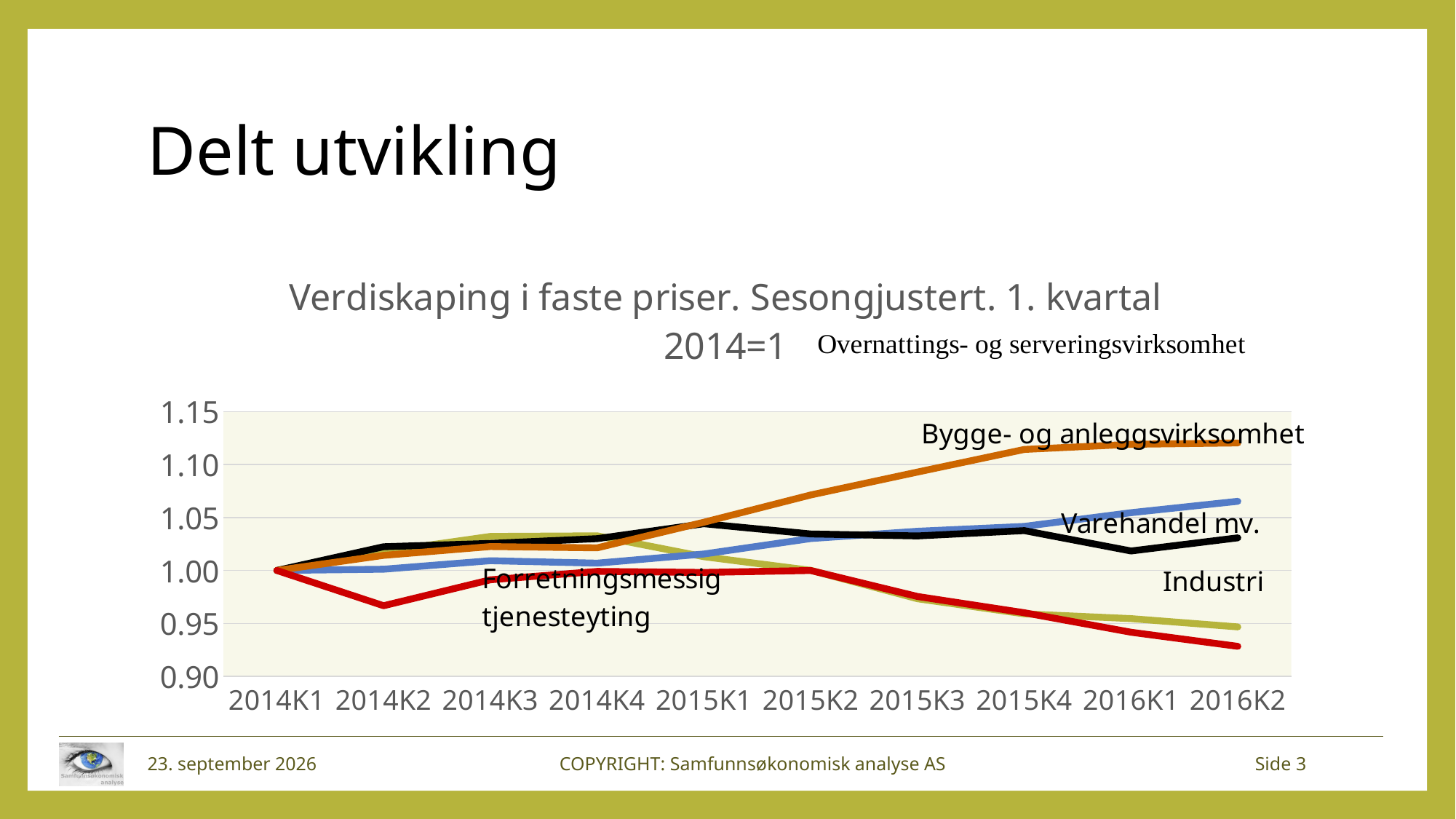
How many quarters are shown along the x axis of the chart? 10 Which series has the highest value at 2016K2? Overnattings- og serveringsvirksomhet Is the value for Bygge- og anleggsvirksomhet at 2016K2 larger than the value for Varehandel mv. at 2016K2? Bygge- og anleggsvirksomhet Is the value for Bygge- og anleggsvirksomhet at 2014K4 greater or less than 1.05? less What is the title of the chart? Verdiskaping i faste priser. Sesongjustert. 1. kvartal 2014=1 How many series are labelled on the chart? 5 What is the first quarter shown on the x axis? 2014K1 What is the value of all series at 2014K1? 1.00 What kind of chart is shown on the slide? line chart Does the Bygge- og anleggsvirksomhet series rise or fall from 2014K1 to 2016K2? rise